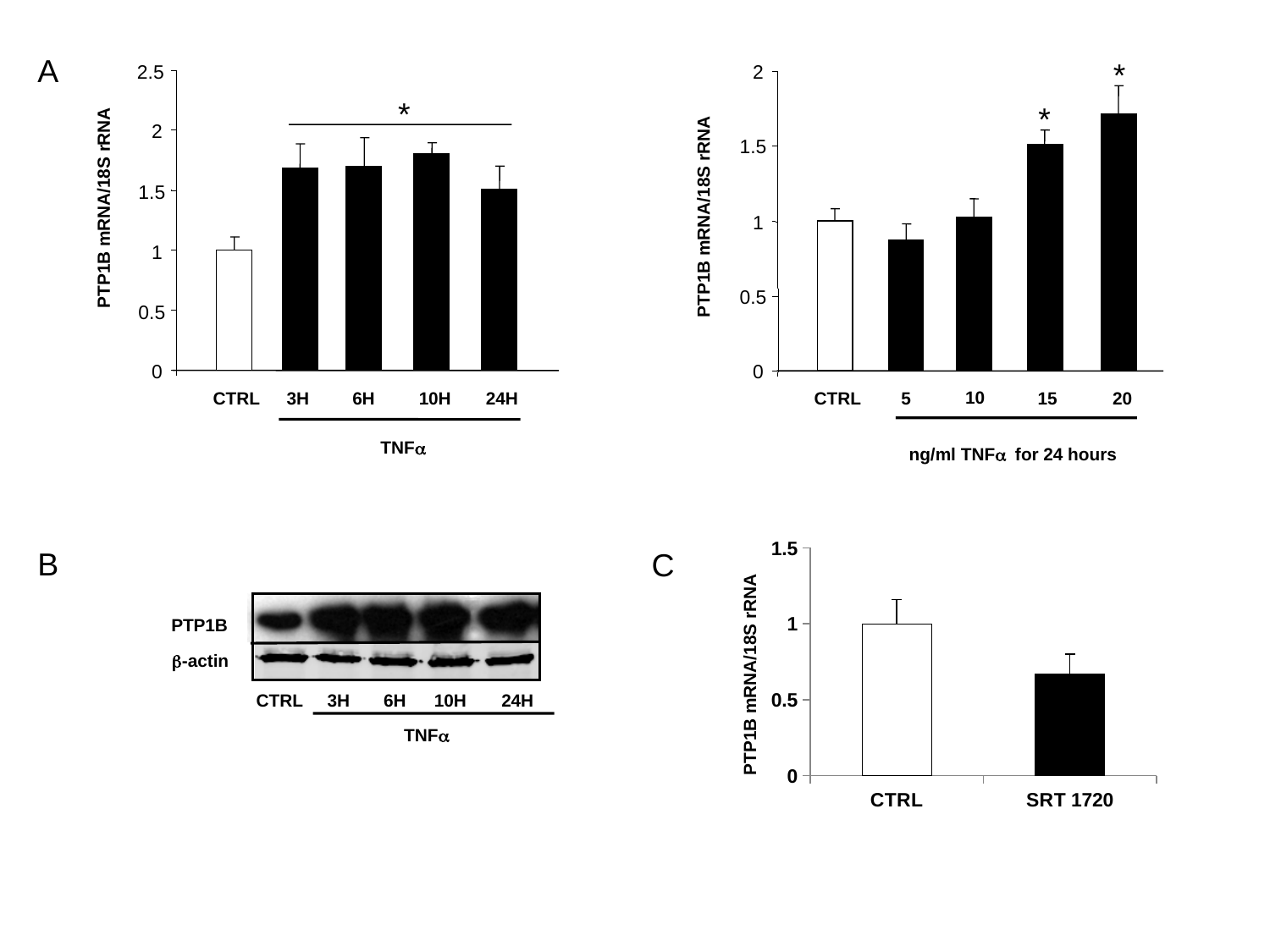
In the chart in panel C, which is larger, the value for CTRL or the value for SRT 1720? CTRL In the left chart of panel A, is the value for 10H greater or less than 1.5? greater In the chart in panel C, is the value for SRT 1720 greater or less than 0.5? greater In the right chart of panel A, which category has the highest bar? 20 In the left chart of panel A, which is larger, the value for CTRL or the value for 3H? 3H In the right chart of panel A, which category has the lowest bar? 5 In the right chart of panel A, is the value for 5 greater or less than 1? less In the left chart of panel A, which category has the lowest bar? CTRL In the left chart of panel A, how many bars are plotted? 5 In the right chart of panel A, what is the x-axis label under the bracketed categories? ng/ml TNFα for 24 hours What kind of chart is shown in panel C? bar chart